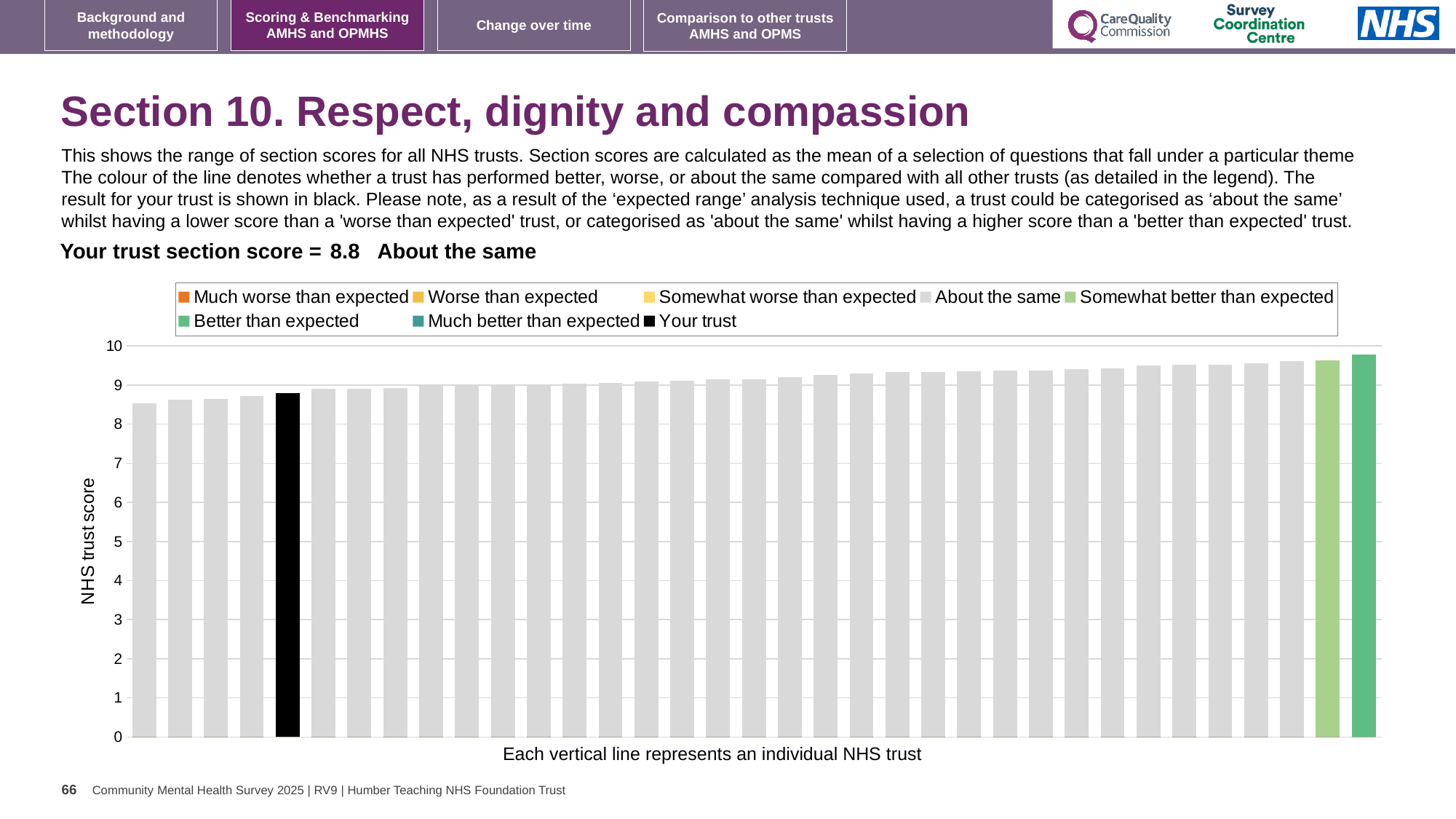
How many entries does the chart legend list? 8 Is the value of the tallest bar greater or less than 9? greater What colour is the bar representing your trust? Black What is the section score for your trust shown on the slide? 8.8 Is the black bar (your trust) higher or lower than the rightmost bar? Lower What is the label on the vertical axis of the chart? NHS trust score Which benchmarking category is your trust placed in for this section? About the same Is the value of the black bar (your trust) greater or less than 8? greater Do the bar values rise or fall from left to right across the chart? Rise Is the value of the black bar (your trust) greater or less than 9? less Which legend category does the tallest bar belong to? Better than expected What kind of chart is shown on the slide? Bar chart